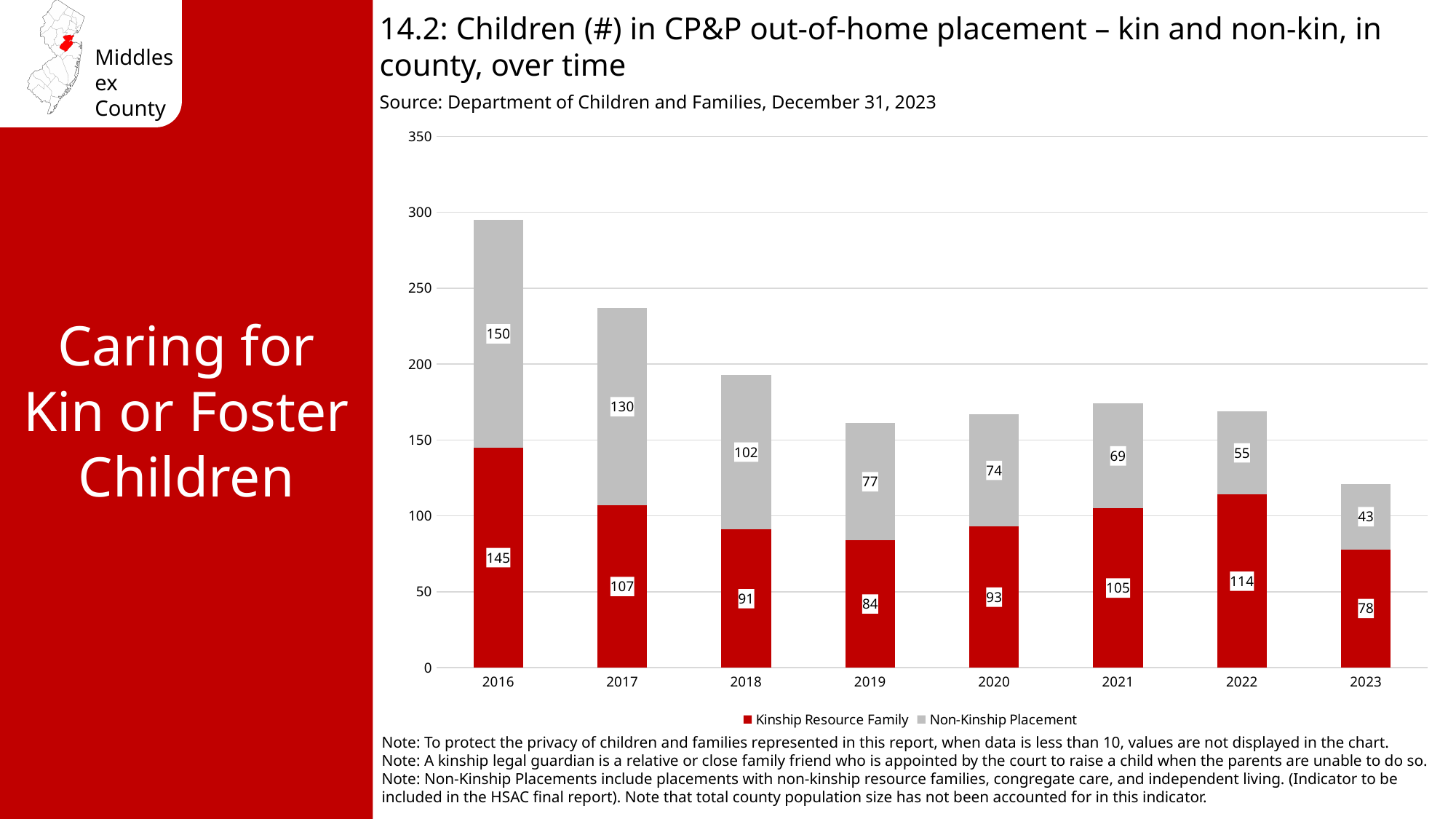
What is the total of the stacked bar for 2018? 193 How many years are shown on the x axis? 8 Which is larger: the Kinship Resource Family value for 2022 or for 2021? 2022 What is the Non-Kinship Placement value for 2023? 43 Which year has the highest Kinship Resource Family value? 2016 What is the total of the stacked bar for 2023? 121 What is the Non-Kinship Placement value for 2019? 77 How many series does the legend list? 2 Which year has the lowest Non-Kinship Placement value? 2023 What is the Kinship Resource Family value for 2016? 145 What kind of chart is shown? Stacked bar chart What is the difference between the Non-Kinship Placement values for 2016 and 2017? 20